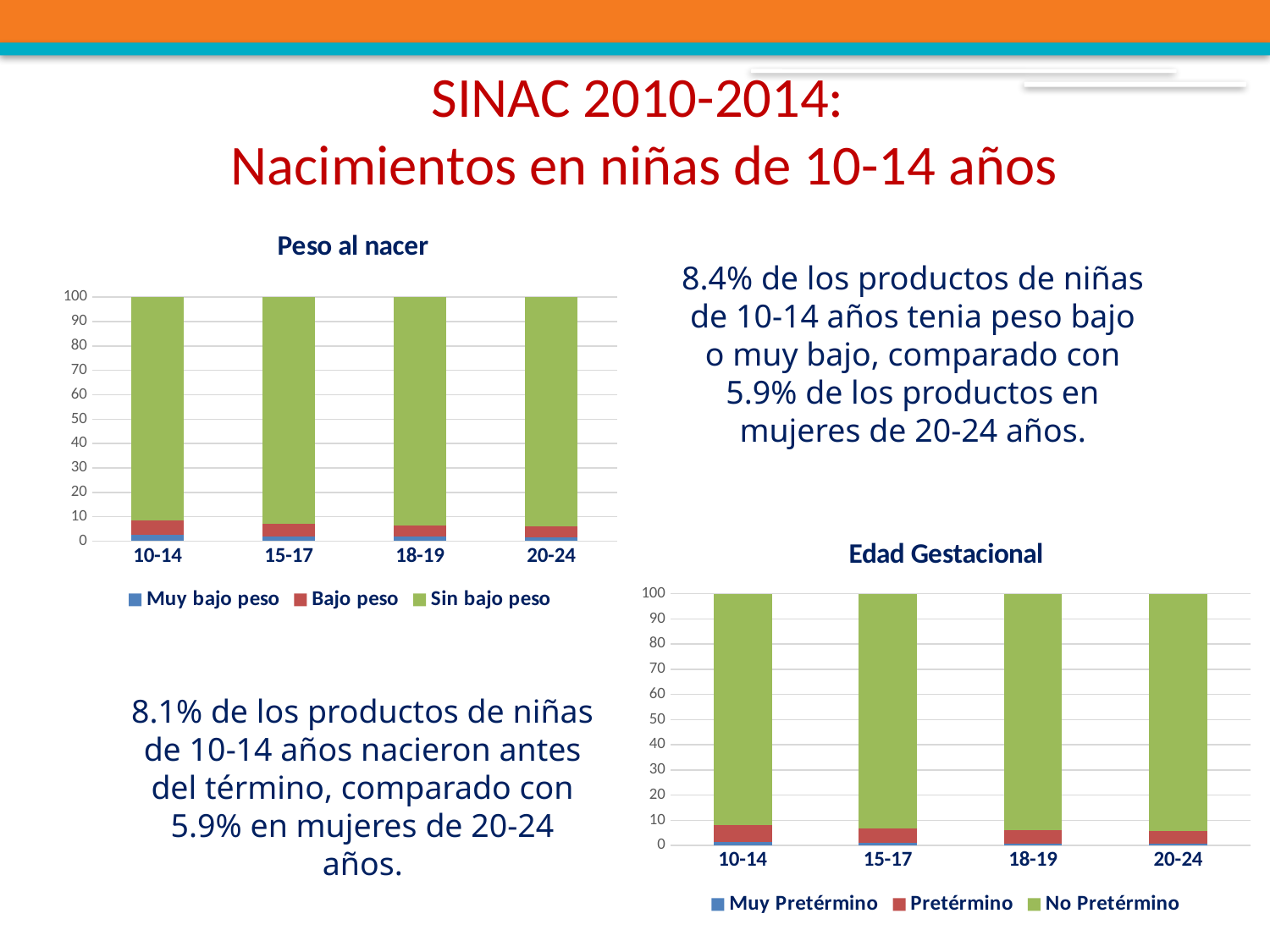
How many age-group categories are shown on the x axis of the "Peso al nacer" chart? 4 In the "Peso al nacer" chart, is the "Bajo peso" segment larger for 10-14 or for 20-24? 10-14 How many series does the legend of the "Edad Gestacional" chart list? 3 How many series does the legend of the "Peso al nacer" chart list? 3 What kind of chart is the "Peso al nacer" chart? stacked bar chart In the "Peso al nacer" chart, what is the total height of the stacked bar for 10-14? 100 What is the title of the chart in the lower right of the slide? Edad Gestacional In the "Peso al nacer" chart, does the combined low-weight portion (Muy bajo peso plus Bajo peso) rise or fall as age group increases along the x axis? fall In the "Edad Gestacional" chart, is the value for "No Pretérmino" in the 20-24 group greater or less than 90? greater In the "Edad Gestacional" chart, which colour represents the "No Pretérmino" series? green In the "Peso al nacer" chart, is the value for "Sin bajo peso" in the 10-14 group greater or less than 80? greater In the "Edad Gestacional" chart, which age group has the largest "Pretérmino" segment? 10-14